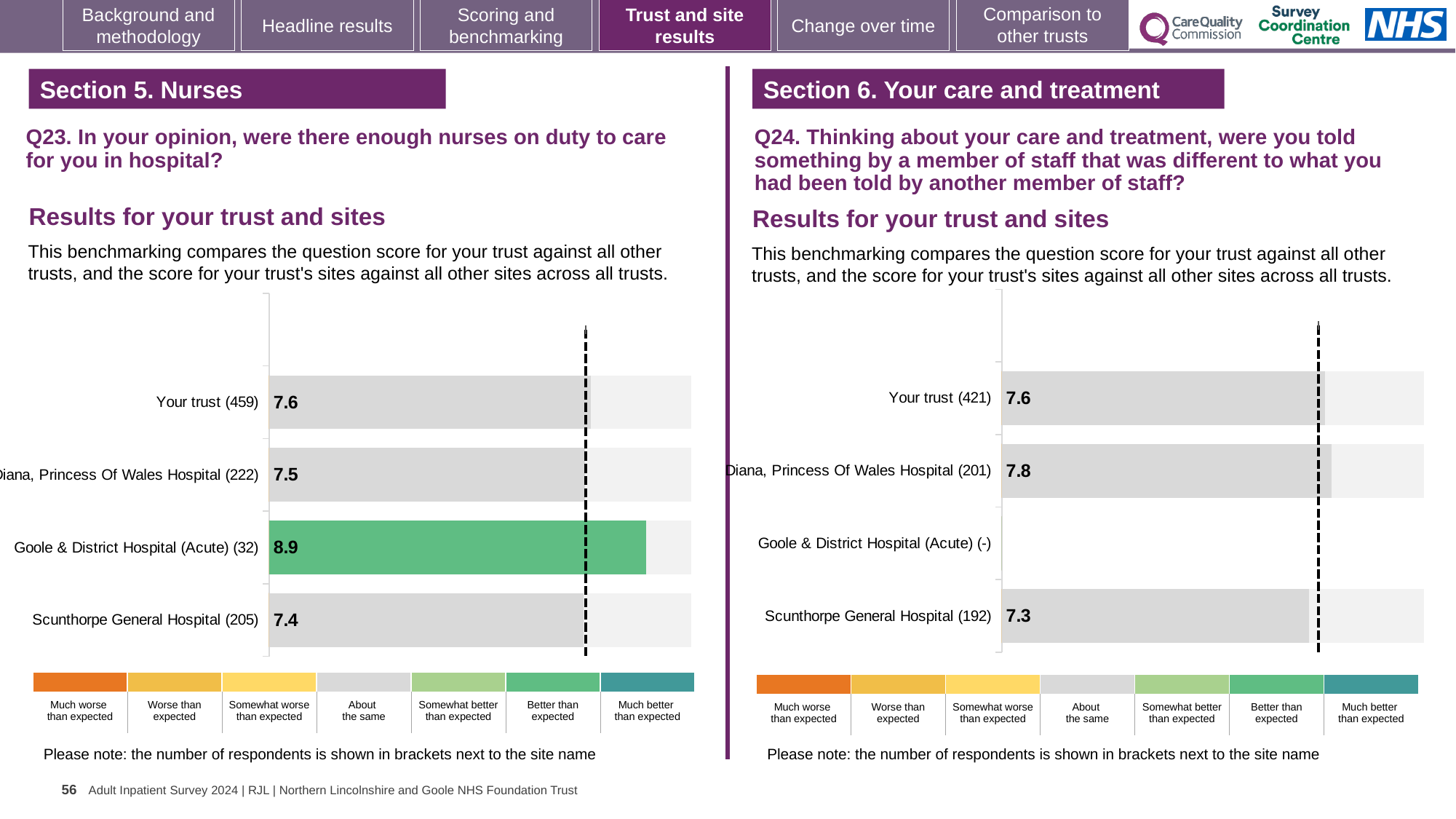
In the Q23 chart on the left, what is the difference between the scores for Goole & District Hospital (Acute) and Scunthorpe General Hospital? 1.5 In the Q23 chart on the left, which bar has the lowest score? Scunthorpe General Hospital (205) In the Q24 chart on the right, is the score for Diana, Princess Of Wales Hospital larger or smaller than the score for Your trust? larger In the Q24 chart on the right, what is the score for Scunthorpe General Hospital (192)? 7.3 In the Q23 chart on the left, what is the score for Goole & District Hospital (Acute) (32)? 8.9 In the Q23 chart on the left, what is the score for Your trust (459)? 7.6 In the Q24 chart on the right, what is the difference between the scores for Diana, Princess Of Wales Hospital and Scunthorpe General Hospital? 0.5 In the Q24 chart on the right, what is the score for Diana, Princess Of Wales Hospital (201)? 7.8 In the Q23 chart on the left, which bar is shown in green rather than grey? Goole & District Hospital (Acute) (32) In the Q24 chart on the right, which site has the highest score? Diana, Princess Of Wales Hospital (201) In the Q23 chart on the left, which site has the highest score? Goole & District Hospital (Acute) (32) What type of chart is used for the Q23 results on the left? Bar chart